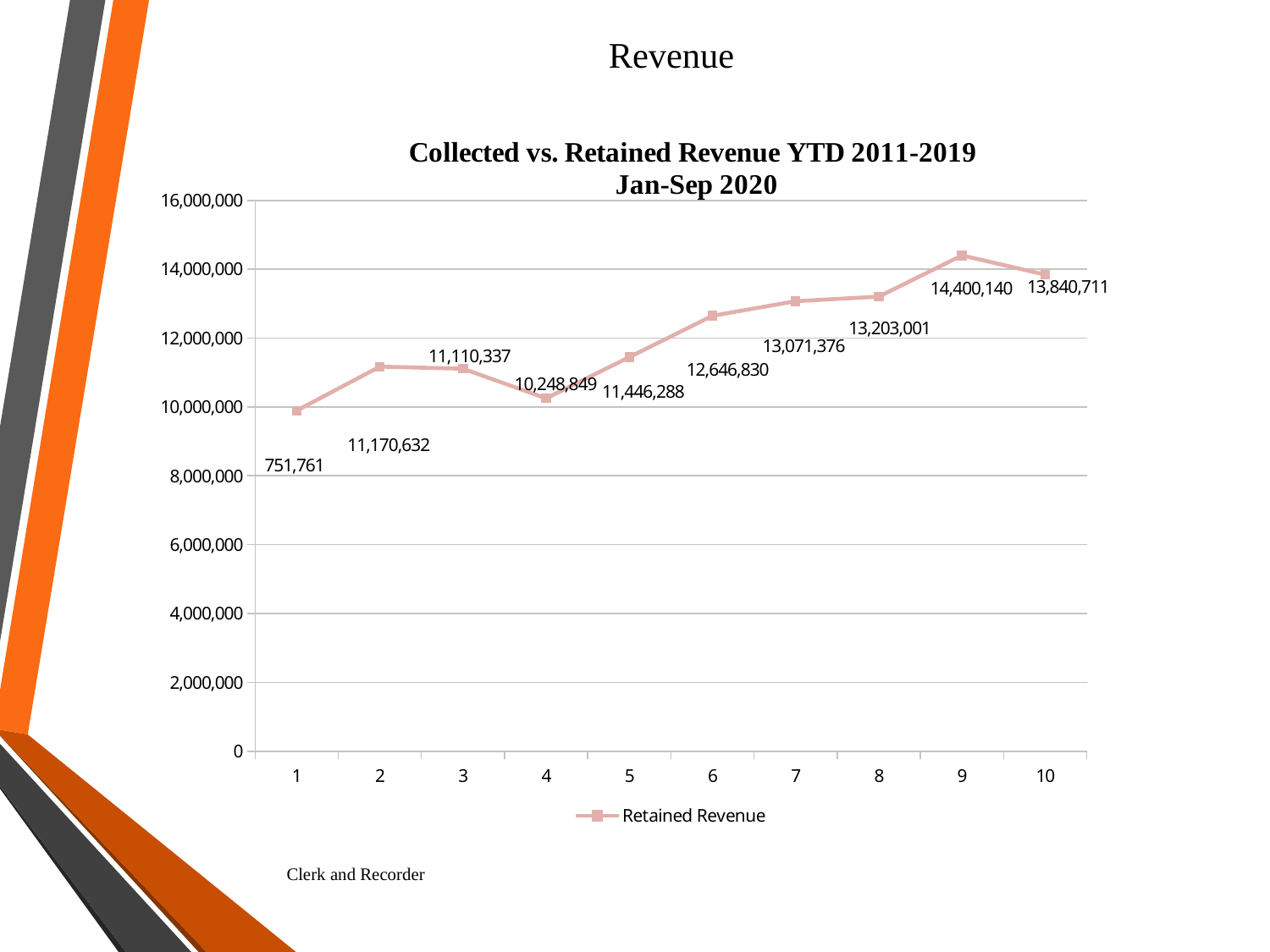
Is the Retained Revenue at point 6 greater or less than 12,000,000? greater How many series does the legend list? 1 What is the Retained Revenue value at point 4? 10,248,849 What is the difference between the Retained Revenue at point 8 and at point 7? 131,625 What is the difference between the Retained Revenue at point 6 and at point 5? 1,200,542 What is the Retained Revenue value at point 9? 14,400,140 Which has the larger Retained Revenue, point 2 or point 3? Point 2 What is the difference between the Retained Revenue at point 9 and at point 10? 559,429 At which point on the x axis is Retained Revenue highest? 9 What is the Retained Revenue value at point 10? 13,840,711 What kind of chart is shown? Line chart How many points are plotted on the x axis? 10